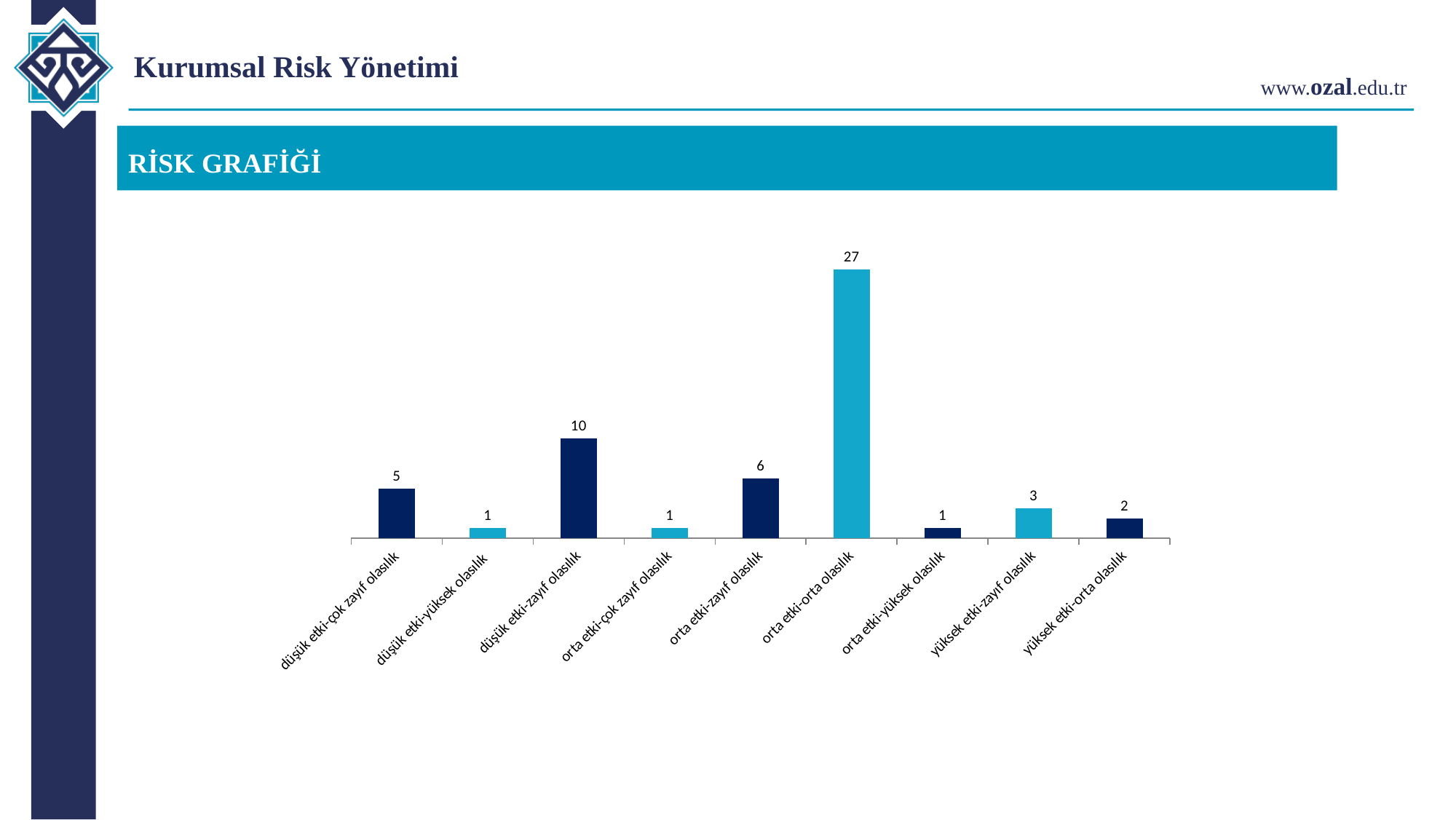
What is the difference between the values for "orta etki-zayıf olasılık" and "yüksek etki-orta olasılık"? 4 What is the value for "düşük etki-çok zayıf olasılık"? 5 What is the value for "yüksek etki-zayıf olasılık"? 3 What is the value for "düşük etki-zayıf olasılık"? 10 What is the value for "orta etki-orta olasılık"? 27 What is the title shown in the banner above the chart? RİSK GRAFİĞİ How many categories are shown on the x axis? 9 What kind of chart is shown on the slide? bar chart How many categories have a value of 1? 3 What is the difference between the values for "orta etki-orta olasılık" and "düşük etki-zayıf olasılık"? 17 Which is larger, the value for "düşük etki-çok zayıf olasılık" or the value for "orta etki-zayıf olasılık"? orta etki-zayıf olasılık Which category has the highest value? orta etki-orta olasılık